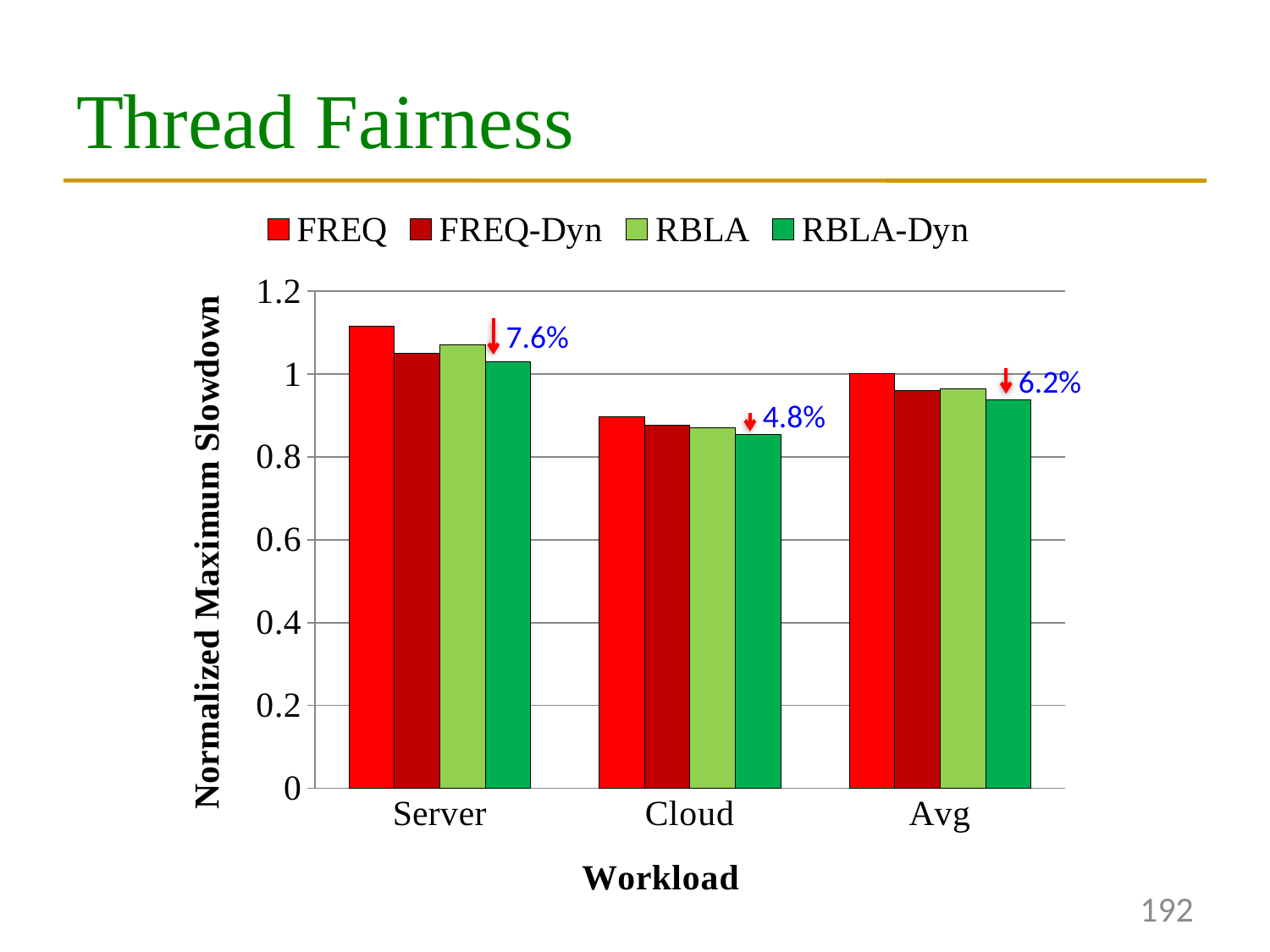
Is the value for FREQ on the Cloud workload greater or less than 1? less How many series does the legend list? 4 What percentage reduction is annotated above the RBLA-Dyn bar for the Avg workload? 6.2% For the Server workload, which is larger, the FREQ bar or the RBLA-Dyn bar? FREQ Which workload has the lowest RBLA-Dyn bar? Cloud What is the label of the y axis? Normalized Maximum Slowdown What percentage reduction is annotated above the RBLA-Dyn bar for the Server workload? 7.6% How many workload categories are shown on the x axis? 3 What kind of chart is shown on the slide? bar chart Which workload has the highest FREQ bar? Server Is the value for FREQ on the Server workload greater or less than 1? greater Is the value for RBLA-Dyn on the Cloud workload greater or less than 0.8? greater